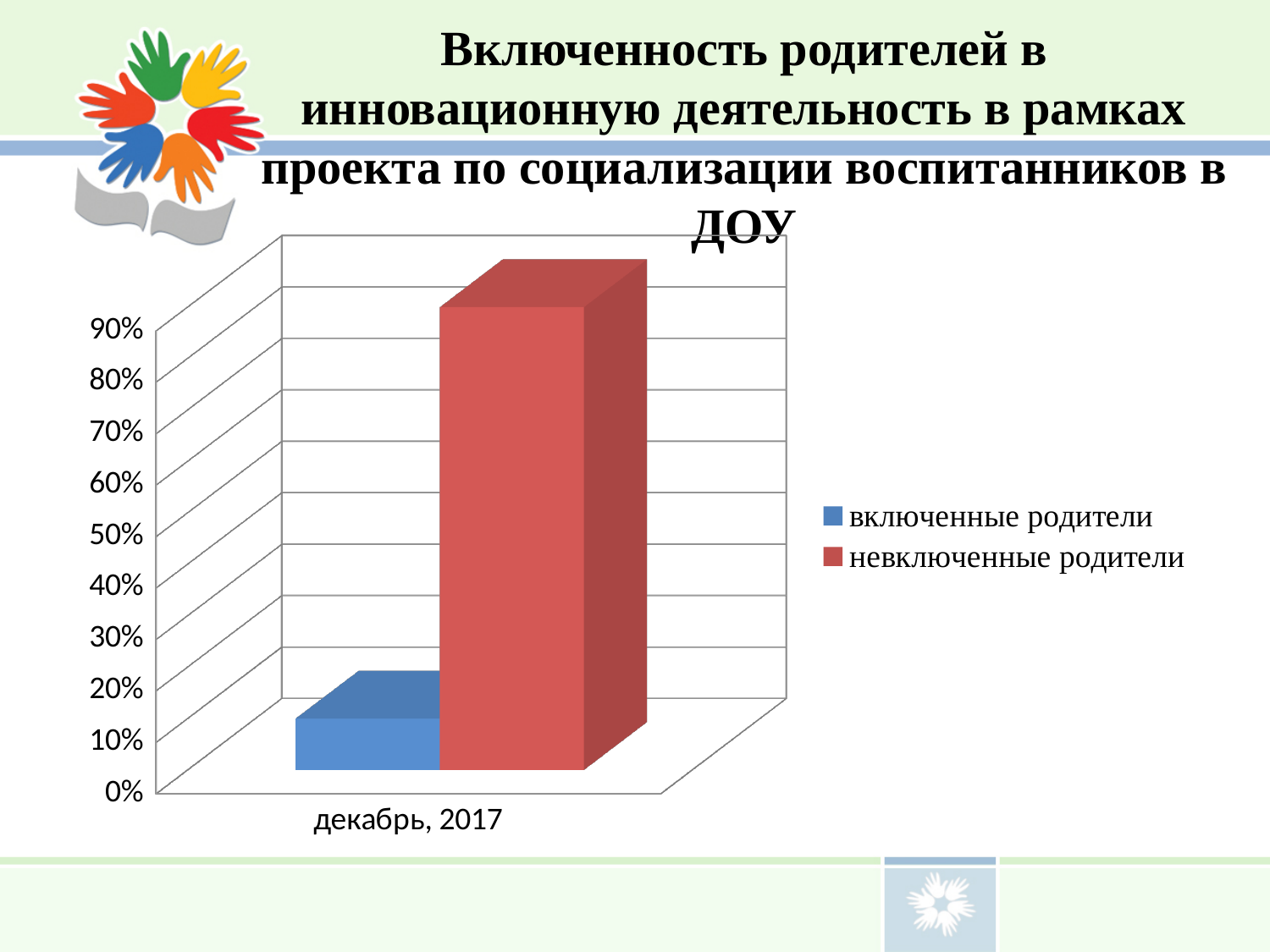
Which series has the lower value for декабрь, 2017? включенные родители Which is larger for декабрь, 2017: включенные родители or невключенные родители? невключенные родители How many series does the legend list? 2 What kind of chart is shown on the slide? bar chart Is the value for невключенные родители greater or less than 80%? greater How many categories are shown on the x axis? 1 Which series has the higher value for декабрь, 2017? невключенные родители Is the value for невключенные родители greater or less than 50%? greater Is the value for включенные родители greater or less than 20%? less What colour is the bar for невключенные родители? red What is the category label shown on the x axis? декабрь, 2017